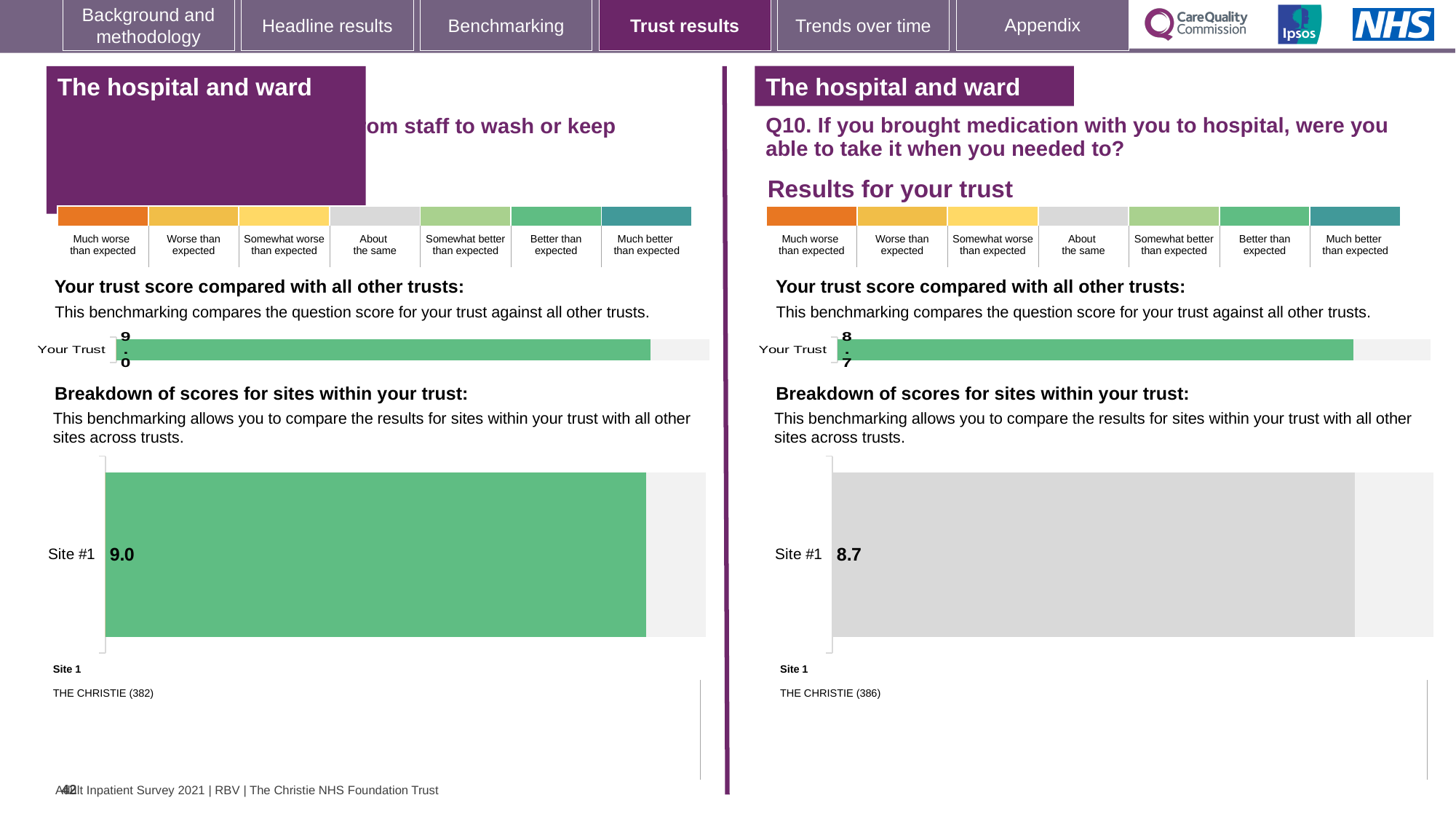
How many sites are shown in the left-hand 'Breakdown of scores for sites within your trust' chart? 1 On the right-hand side of the slide (Q10, medication), what score is shown for Site #1 in the 'Breakdown of scores for sites within your trust' chart? 8.7 In the right-hand (Q10) breakdown chart, what colour is the Site #1 bar? Grey On the left-hand side of the slide, what score is shown for Site #1 in the 'Breakdown of scores for sites within your trust' chart? 9.0 On the left-hand side of the slide, what is the score shown for Your Trust in the 'Your trust score compared with all other trusts' chart? 9.0 On the right-hand side of the slide (Q10, medication), what is the score shown for Your Trust in the 'Your trust score compared with all other trusts' chart? 8.7 Which is larger: the Site #1 score in the left-hand breakdown chart or the Site #1 score in the right-hand (Q10) breakdown chart? The left-hand Site #1 score (9.0) In the left-hand breakdown chart, what colour is the Site #1 bar? Green What type of chart is used for the 'Breakdown of scores for sites within your trust' on the right-hand side of the slide? Bar chart What is the difference between the Your Trust score on the left-hand side (9.0) and the Your Trust score on the right-hand side (8.7)? 0.3 Which site name is listed under 'Site 1' for the right-hand (Q10) breakdown chart? THE CHRISTIE (386) How many sites are shown in the right-hand (Q10) 'Breakdown of scores for sites within your trust' chart? 1